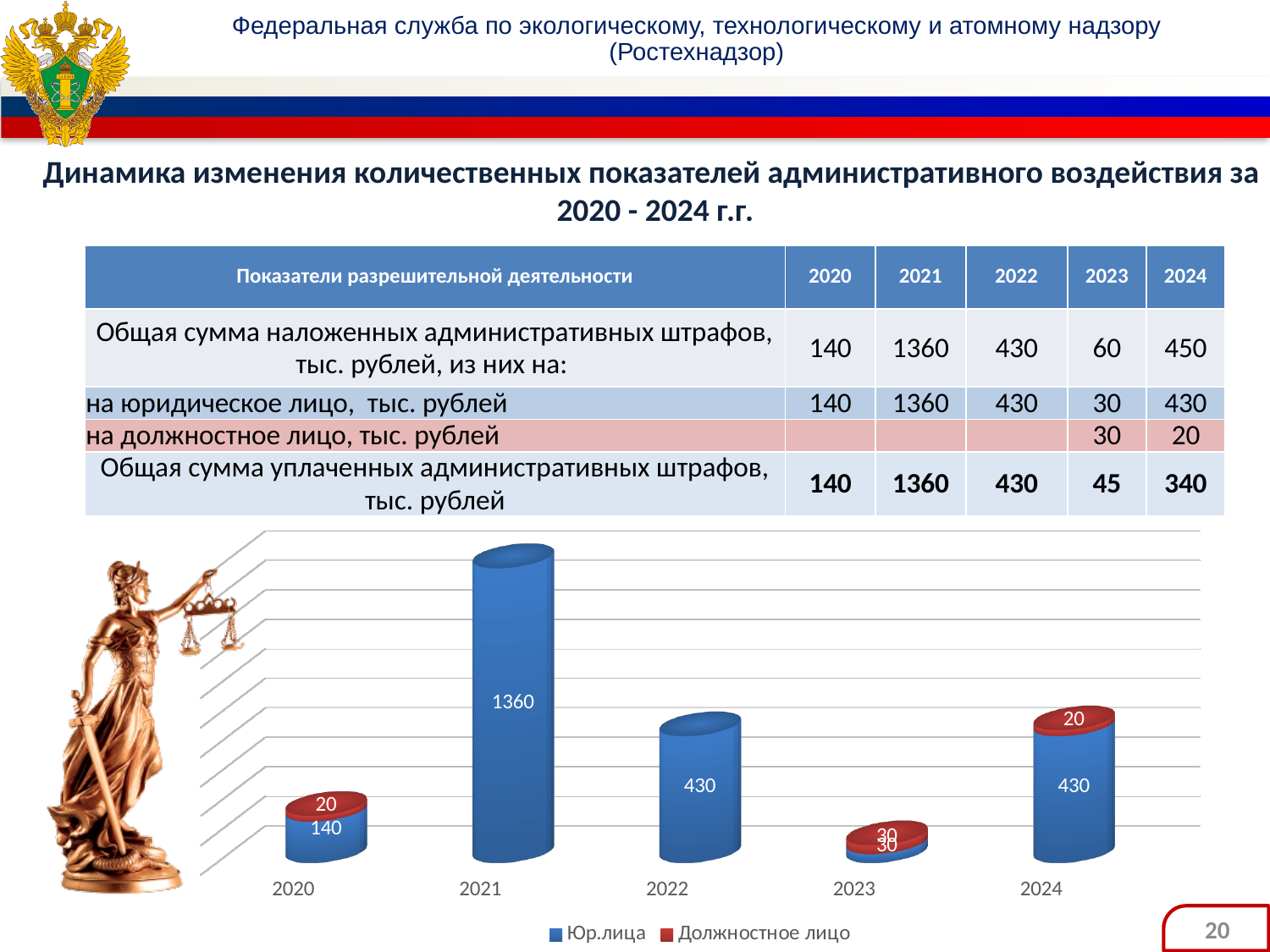
What is the value for Юр.лица in 2020 on the chart? 140 How many years (categories) are shown on the x axis of the chart? 5 How many series does the chart legend list? 2 In which year is the Юр.лица value highest on the chart? 2021 What is the value for Юр.лица in 2022 on the chart? 430 Which year has the larger Юр.лица value on the chart, 2021 or 2022? 2021 What is the value for Должностное лицо in 2024 on the chart? 20 What kind of chart is shown at the bottom of the slide? bar chart In which year is the Юр.лица value lowest on the chart? 2023 What is the difference between the Юр.лица values for 2021 and 2022 on the chart? 930 What is the value for Юр.лица in 2021 on the chart? 1360 What are the two series named in the chart legend? Юр.лица and Должностное лицо